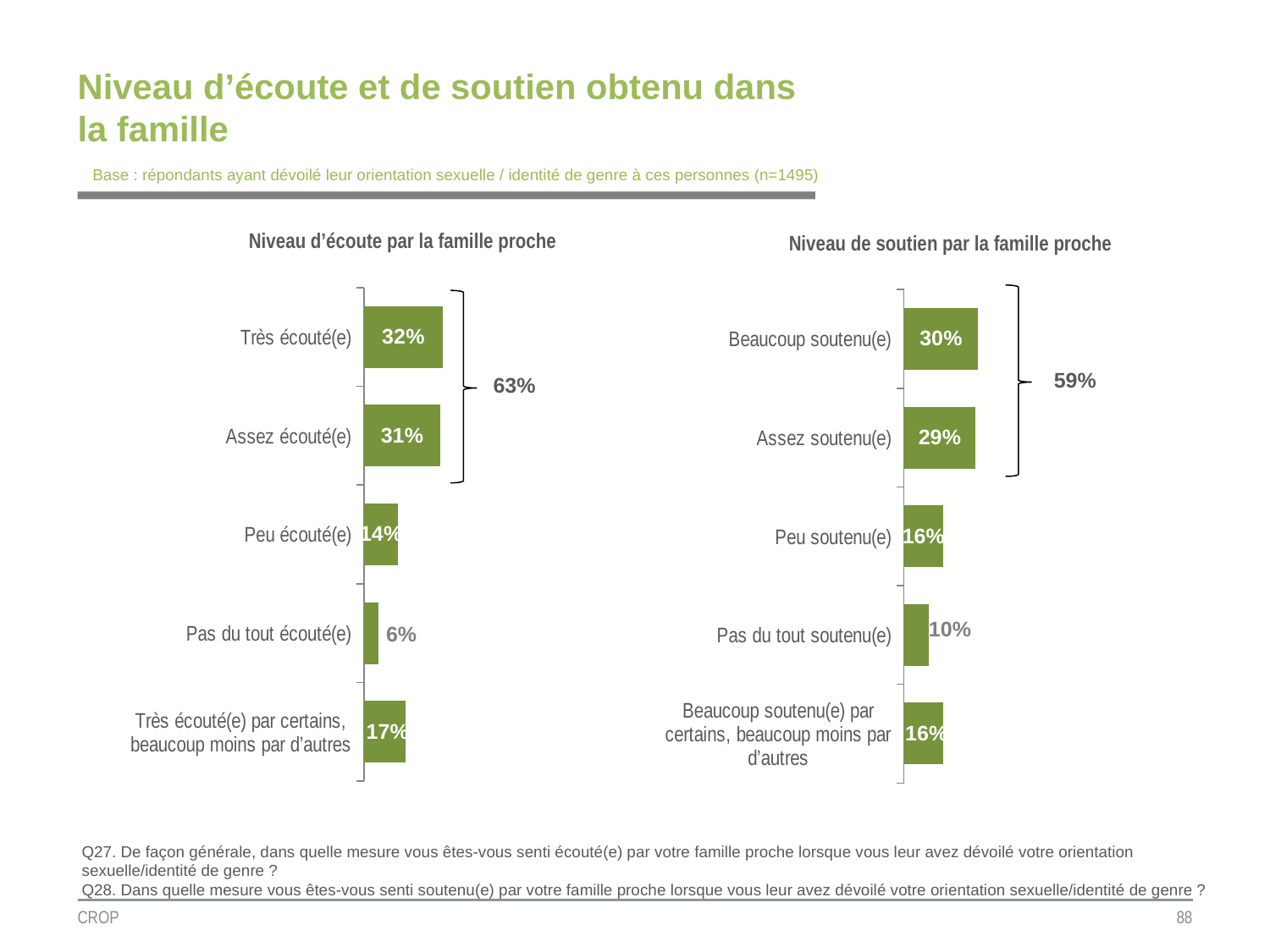
In the chart 'Niveau de soutien par la famille proche', what combined value is shown by the bracket for 'Beaucoup soutenu(e)' and 'Assez soutenu(e)'? 59% In the chart 'Niveau d’écoute par la famille proche', which category has the lowest value? Pas du tout écouté(e) In the chart 'Niveau de soutien par la famille proche', what is the value for 'Pas du tout soutenu(e)'? 10% What is the value for 'Peu soutenu(e)' in the chart 'Niveau de soutien par la famille proche'? 16% How many categories are shown in the chart 'Niveau de soutien par la famille proche'? 5 In the chart 'Niveau de soutien par la famille proche', what is the difference between 'Assez soutenu(e)' and 'Peu soutenu(e)'? 13% In the chart 'Niveau d’écoute par la famille proche', what is the value for 'Très écouté(e)'? 32% In the chart 'Niveau d’écoute par la famille proche', what is the difference between 'Très écouté(e)' and 'Pas du tout écouté(e)'? 26% In the chart 'Niveau de soutien par la famille proche', which category has the highest value? Beaucoup soutenu(e) In the chart 'Niveau d’écoute par la famille proche', which is larger: 'Peu écouté(e)' or 'Très écouté(e) par certains, beaucoup moins par d’autres'? Très écouté(e) par certains, beaucoup moins par d’autres What kind of chart is 'Niveau d’écoute par la famille proche'? Bar chart In the chart 'Niveau d’écoute par la famille proche', what combined value is shown by the bracket for 'Très écouté(e)' and 'Assez écouté(e)'? 63%